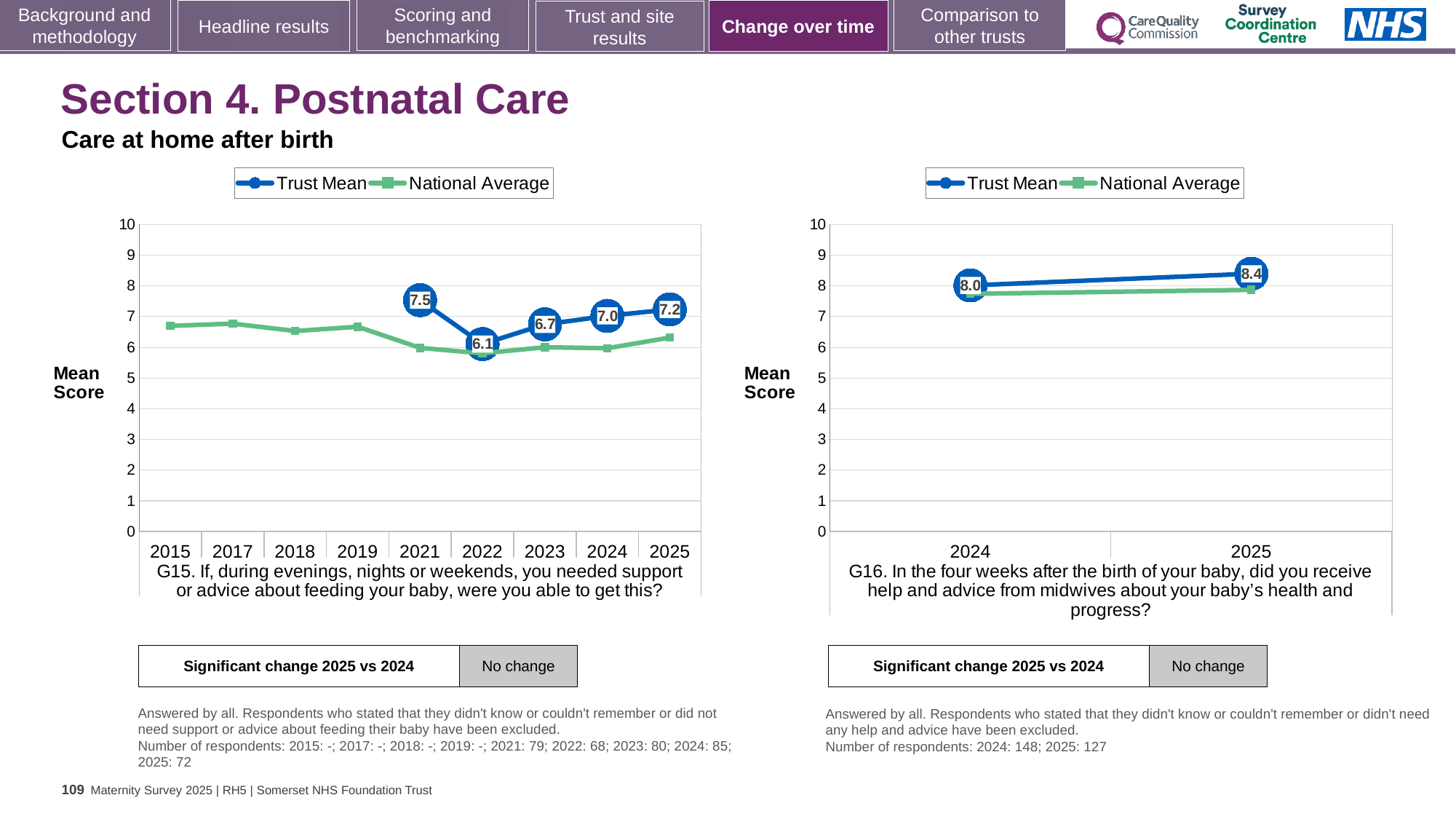
In the G16 chart on the right, does the Trust Mean rise or fall from 2024 to 2025? rise In the G15 chart on the left, which year has the highest Trust Mean? 2021 How many series does the legend of the G16 chart on the right list? 2 In the G16 chart on the right, what is the Trust Mean for 2025? 8.4 In the G15 chart on the left, how many years are shown on the x axis? 9 In the G15 chart on the left, what is the difference between the Trust Mean for 2021 and 2022? 1.4 In the G15 chart on the left, which year has the lowest Trust Mean? 2022 In the G15 chart on the left, is the National Average for 2015 greater or less than 6? greater In the G15 chart on the left, is the Trust Mean higher in 2023 or 2024? 2024 In the G15 chart on the left, what is the Trust Mean for 2025? 7.2 In the G16 chart on the right, what is the difference between the Trust Mean for 2025 and 2024? 0.4 In the G15 chart on the left, what is the Trust Mean for 2022? 6.1